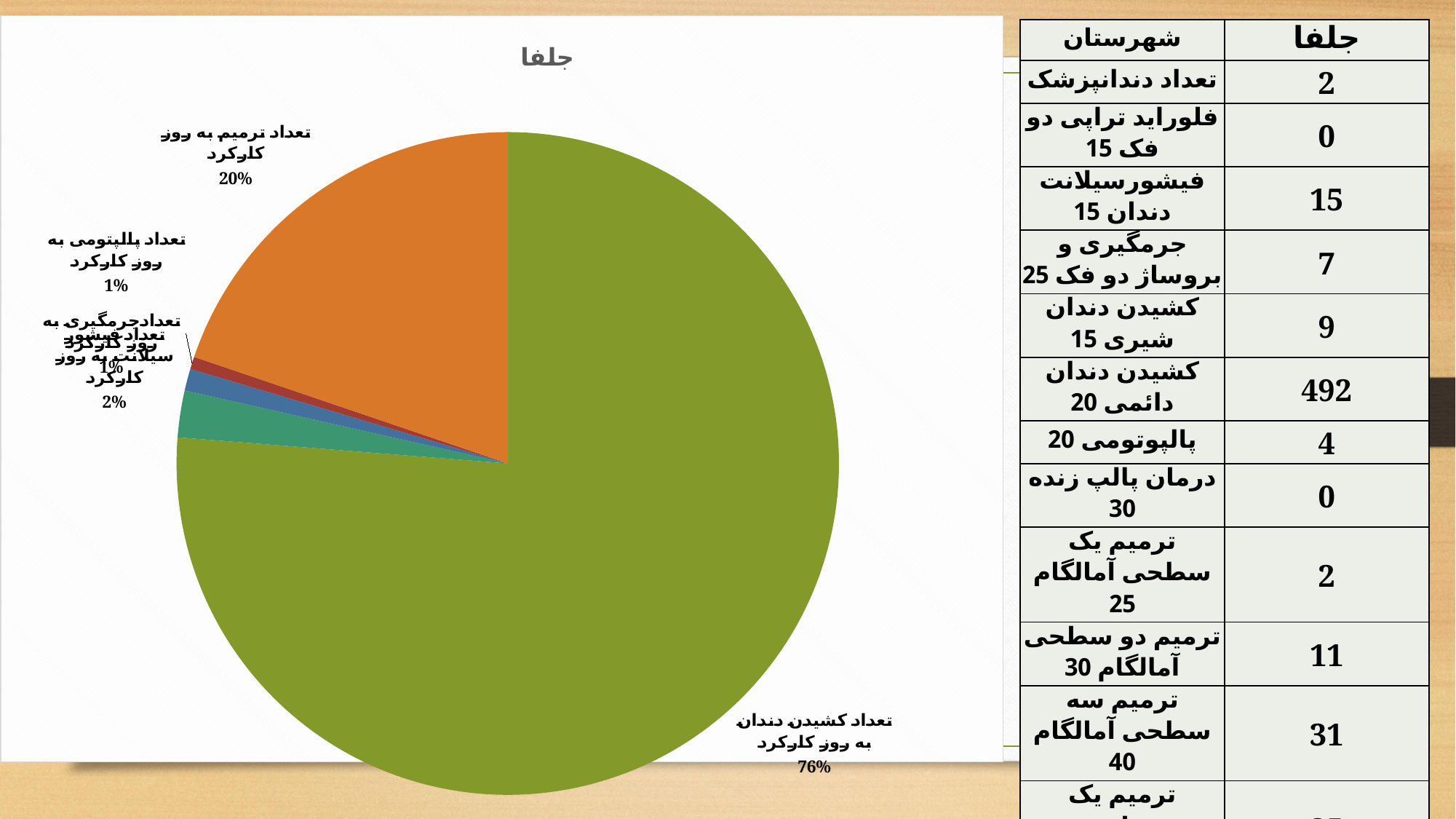
What is the difference in percentage points between the slice for تعداد کشیدن دندان به روز کارکرد and the slice for تعداد ترمیم به روز کارکرد? 56 percentage points Which is larger: the slice for تعداد ترمیم به روز کارکرد or the slice for تعداد فیشور سیلانت به روز کارکرد? تعداد ترمیم به روز کارکرد What share of the pie does تعداد جرمگیری به روز کارکرد represent? 1% What is the title of the pie chart? جلفا What share of the pie does تعداد کشیدن دندان به روز کارکرد represent? 76% What share of the pie does تعداد فیشور سیلانت به روز کارکرد represent? 2% What colour is the largest slice of the pie chart? green How many slices does the pie chart have? 5 Which category has the largest slice of the pie? تعداد کشیدن دندان به روز کارکرد What kind of chart is shown on the slide? pie chart